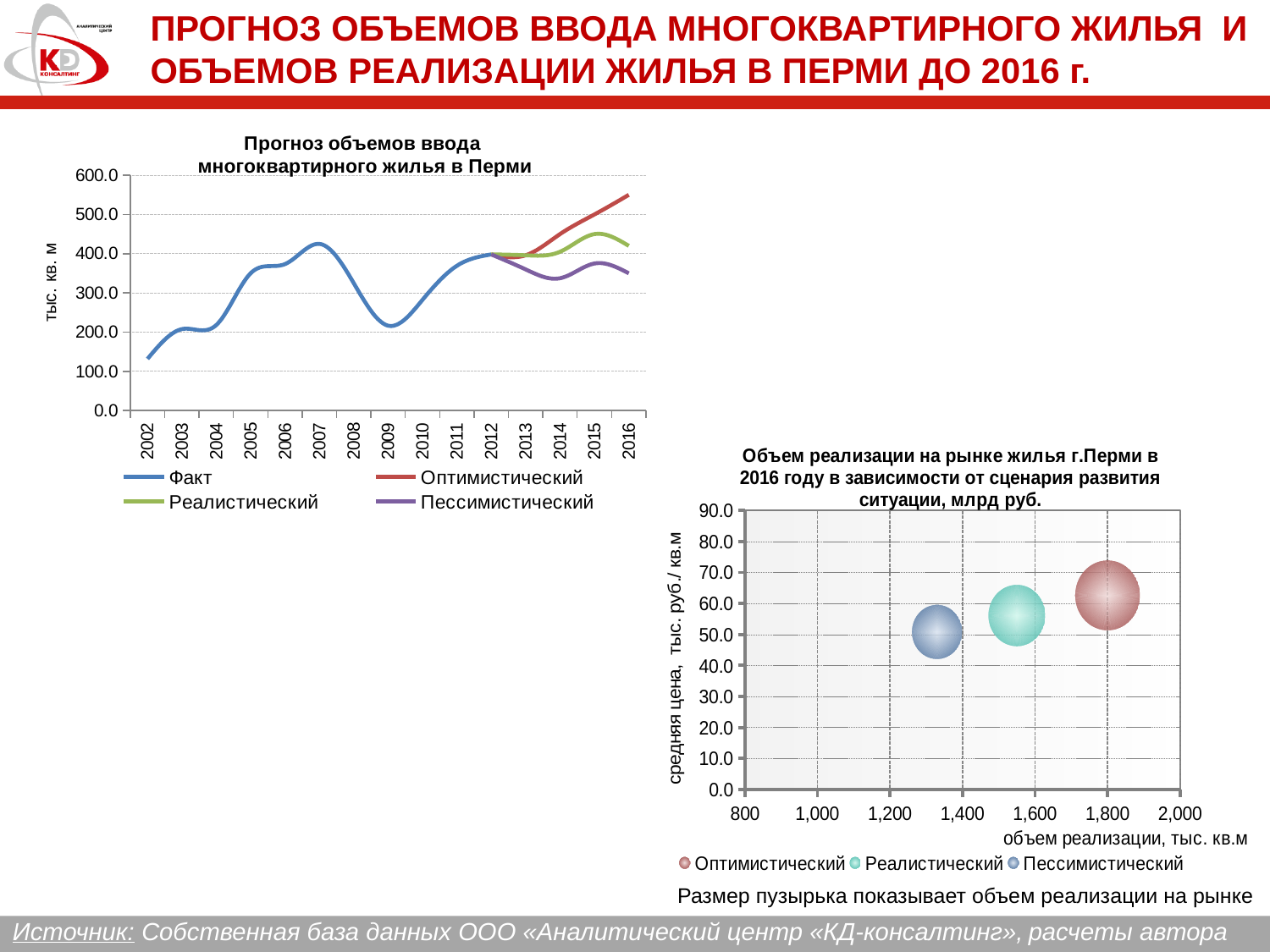
In the bubble chart on the right, how many series does the legend list? 3 What kind of chart is the chart titled "Объем реализации на рынке жилья г.Перми в 2016 году в зависимости от сценария развития ситуации, млрд руб."? bubble chart In the line chart on the left, is the value of the Оптимистический series in 2016 greater or less than 500.0? greater What kind of chart is the chart titled "Прогноз объемов ввода многоквартирного жилья в Перми"? line chart In the bubble chart on the right, which scenario has the largest sales volume (объем реализации)? Оптимистический In the line chart on the left, which scenario has the highest value in 2016? Оптимистический In the line chart on the left, how many years are shown on the x axis? 15 In the line chart on the left, how many series does the legend list? 4 In the line chart on the left, does the Оптимистический series rise or fall from 2012 to 2016? rise In the line chart on the left, which scenario has the lowest value in 2016? Пессимистический In the line chart on the left, is the value of the Пессимистический series in 2016 greater or less than 400.0? less In the bubble chart on the right, how many bubbles are plotted? 3